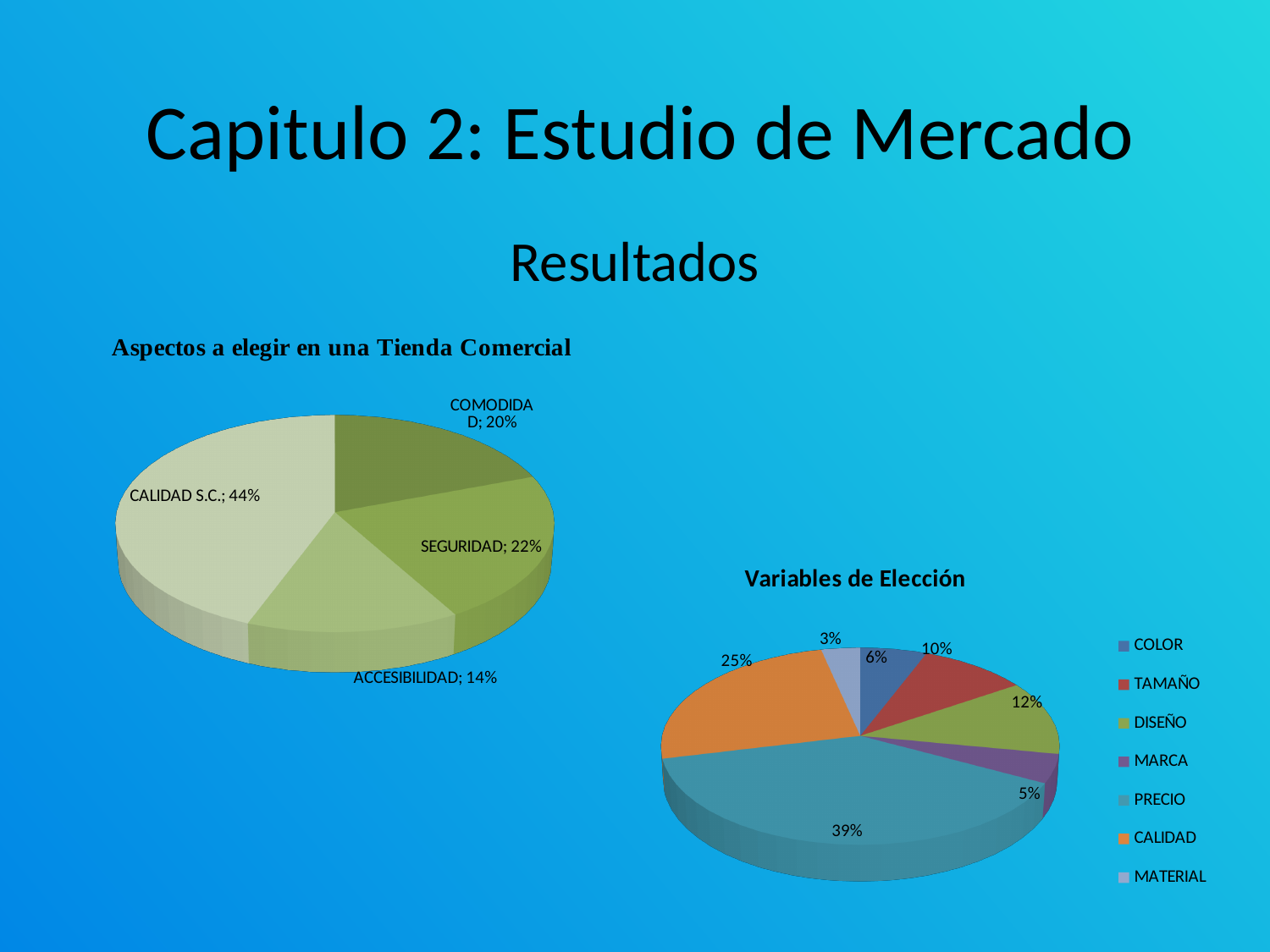
What kind of chart is 'Variables de Elección'? Pie chart In the 'Variables de Elección' chart, which variable has the smallest share? MATERIAL In the 'Variables de Elección' chart, which is larger, the share for TAMAÑO or the share for DISEÑO? DISEÑO In the 'Aspectos a elegir en una Tienda Comercial' chart, which category has the largest share? CALIDAD S.C. How many entries does the legend of the 'Variables de Elección' chart list? 7 In the 'Aspectos a elegir en una Tienda Comercial' chart, what is the difference between the SEGURIDAD and COMODIDAD shares? 2% In the 'Aspectos a elegir en una Tienda Comercial' chart, which category has the smallest share? ACCESIBILIDAD In the 'Variables de Elección' chart, what share does CALIDAD have? 25% In the 'Variables de Elección' chart, what share does PRECIO have? 39% How many categories are shown in the 'Aspectos a elegir en una Tienda Comercial' chart? 4 In the 'Aspectos a elegir en una Tienda Comercial' chart, what share does ACCESIBILIDAD have? 14% In the 'Aspectos a elegir en una Tienda Comercial' chart, what share does CALIDAD S.C. have? 44%